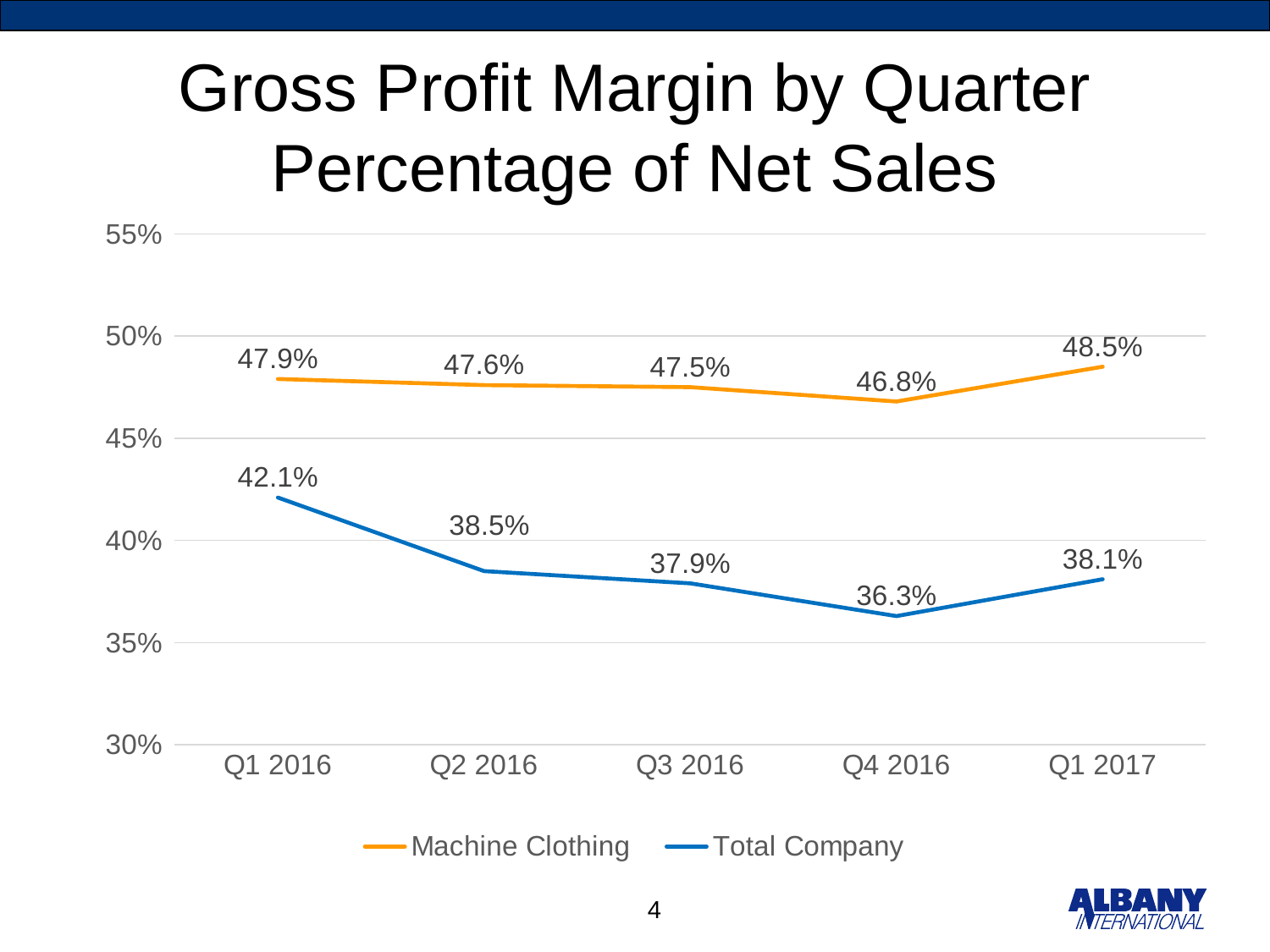
How many series does the legend list? 2 In which quarter is the Machine Clothing gross profit margin highest? Q1 2017 What is the Total Company value in Q1 2016? 42.1% Does the Total Company line rise or fall from Q1 2016 to Q4 2016? Fall What is the difference between the Machine Clothing and Total Company values in Q2 2016? 9.1% Which colour is used for the Total Company line? Blue In which quarter is the Total Company gross profit margin lowest? Q4 2016 How many quarters are shown on the x axis? 5 What kind of chart is shown on the slide? Line chart Which is larger in Q3 2016: Machine Clothing or Total Company? Machine Clothing What is the Total Company gross profit margin in Q4 2016? 36.3% What is the Machine Clothing gross profit margin in Q1 2017? 48.5%